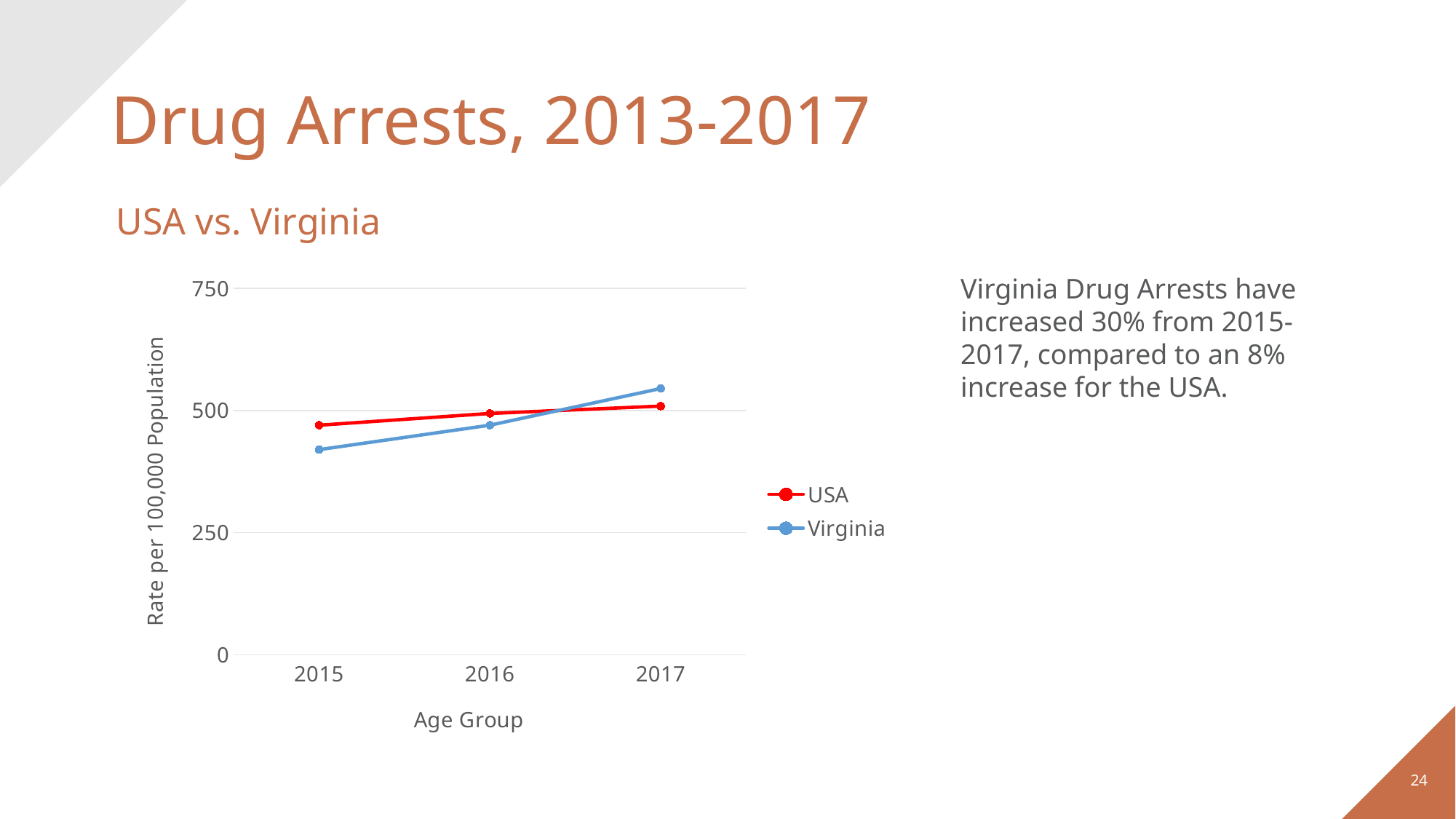
How many series does the legend list? 2 What is the label on the y axis? Rate per 100,000 Population Is the value for Virginia in 2017 greater or less than 500? greater Is the value for Virginia in 2015 greater or less than 500? less Is the value for Virginia in 2016 greater or less than 500? less In 2017, which series has the higher value, USA or Virginia? Virginia What kind of chart is shown on the slide? line chart Which colour is used for the Virginia series? blue How many years are plotted along the x axis? 3 Does the Virginia line rise or fall from 2015 to 2017? rise In 2015, which series has the higher value, USA or Virginia? USA